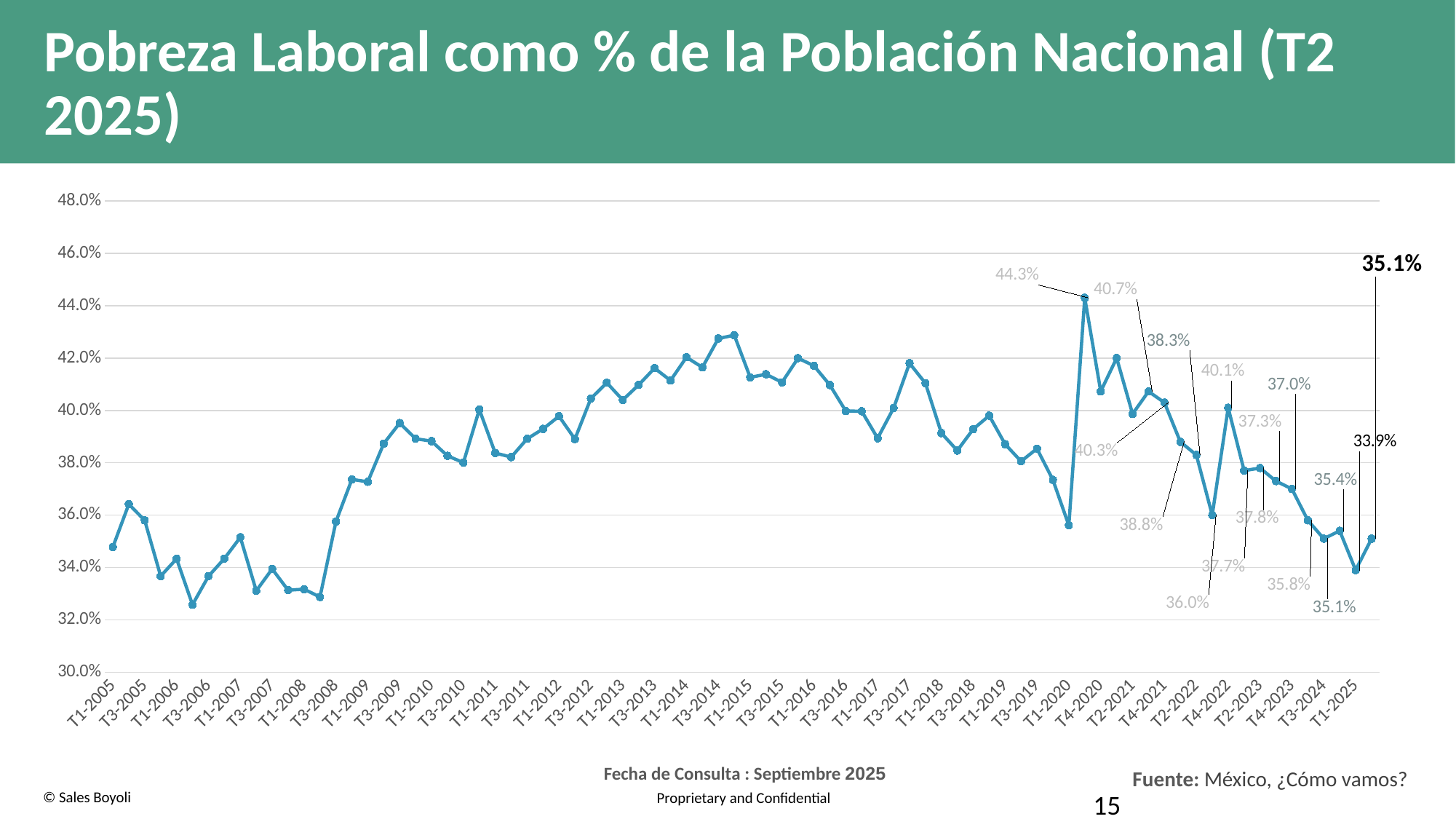
Is the value for T3-2006 greater or less than 34.0%? less What is the title of the chart on the slide? Pobreza Laboral como % de la Población Nacional (T2 2025) What is the value for T1-2025? 33.9% What is the difference between the highest value on the chart (44.3%) and the final value for T2-2025 (35.1%)? 9.2 percentage points What is the difference between the value for T2-2025 and the value for T1-2025? 1.2 percentage points What kind of chart is shown on the slide? Line chart Is the value for T1-2005 greater or less than 36.0%? less Between T1-2005 and T3-2014, does the value generally rise or fall? rise Which is larger, the value for T1-2025 or the value for T2-2025? T2-2025 What is the highest value shown on the chart? 44.3% What is the value for T2-2025, the last point on the chart? 35.1% Is the value for T3-2014 greater or less than 42.0%? greater